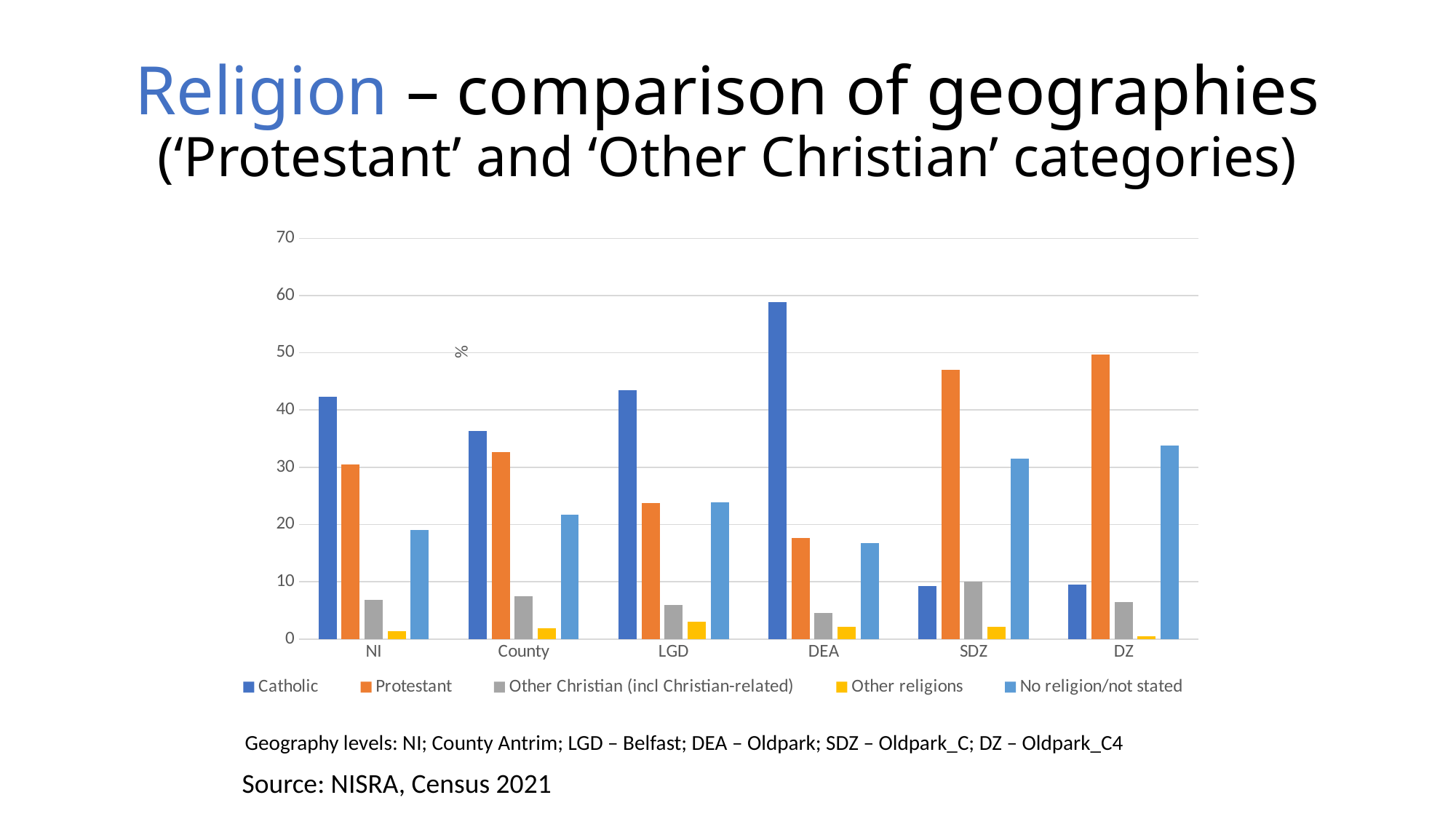
How many series does the legend list? 5 Is the No religion/not stated value for DZ greater or less than 30? greater For SDZ, which is larger: the Protestant value or the Catholic value? Protestant What kind of chart is shown on the slide? Bar chart In which geography is the Catholic value highest? DEA Is the Catholic value for DEA greater or less than 50? greater Is the Catholic value for LGD greater or less than 40? greater In which geography is the Other religions value lowest? DZ For NI, which is larger: the Catholic value or the Protestant value? Catholic In which geography is the Protestant value highest? DZ How many geography categories are shown on the x axis? 6